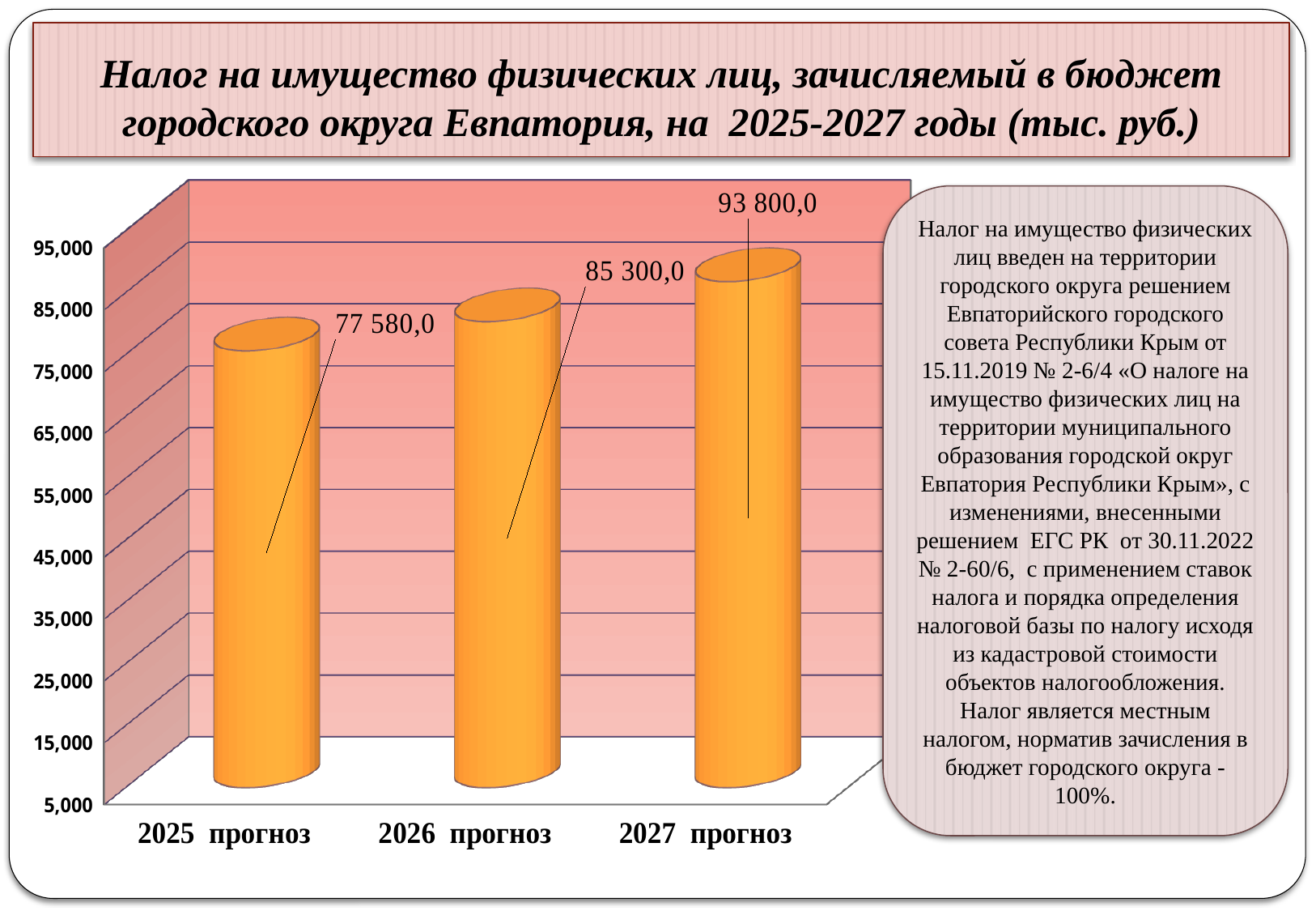
What is the difference between the values for 2027 прогноз and 2026 прогноз? 8 500,0 What is the value for 2025 прогноз? 77 580,0 What is the value for 2027 прогноз? 93 800,0 What kind of chart is shown on the slide? bar chart What is the value for 2026 прогноз? 85 300,0 Which category has the lowest value? 2025 прогноз Which is larger, the value for 2025 прогноз or the value for 2026 прогноз? 2026 прогноз Do the values rise or fall from 2025 прогноз to 2027 прогноз? rise Which category has the highest value? 2027 прогноз What is the difference between the values for 2026 прогноз and 2025 прогноз? 7 720,0 How many categories are shown on the x axis? 3 Is the value for 2027 прогноз greater or less than 85,000? greater